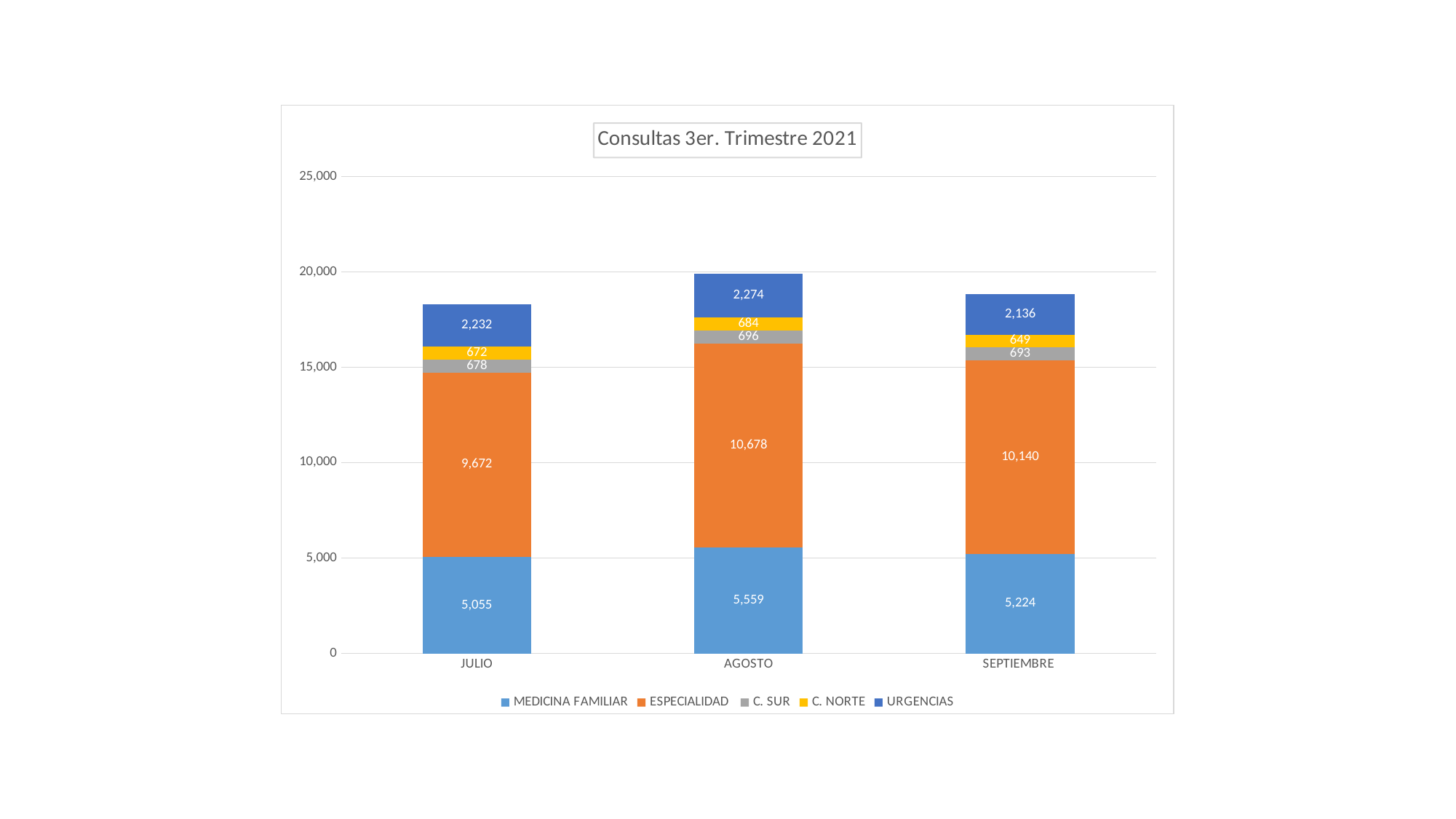
Which is larger, URGENCIAS in AGOSTO or URGENCIAS in SEPTIEMBRE? URGENCIAS in AGOSTO What is the difference between the ESPECIALIDAD values for AGOSTO and JULIO? 1,006 How many months are shown on the x axis? 3 Which month has the highest value for ESPECIALIDAD? AGOSTO What is the value for ESPECIALIDAD in AGOSTO? 10,678 What is the total of the stacked bar for JULIO? 18,309 What is the value for MEDICINA FAMILIAR in SEPTIEMBRE? 5,224 How many series does the legend list? 5 What is the title of the chart? Consultas 3er. Trimestre 2021 Which month has the lowest value for MEDICINA FAMILIAR? JULIO What is the value for C. NORTE in SEPTIEMBRE? 649 What is the value for URGENCIAS in JULIO? 2,232